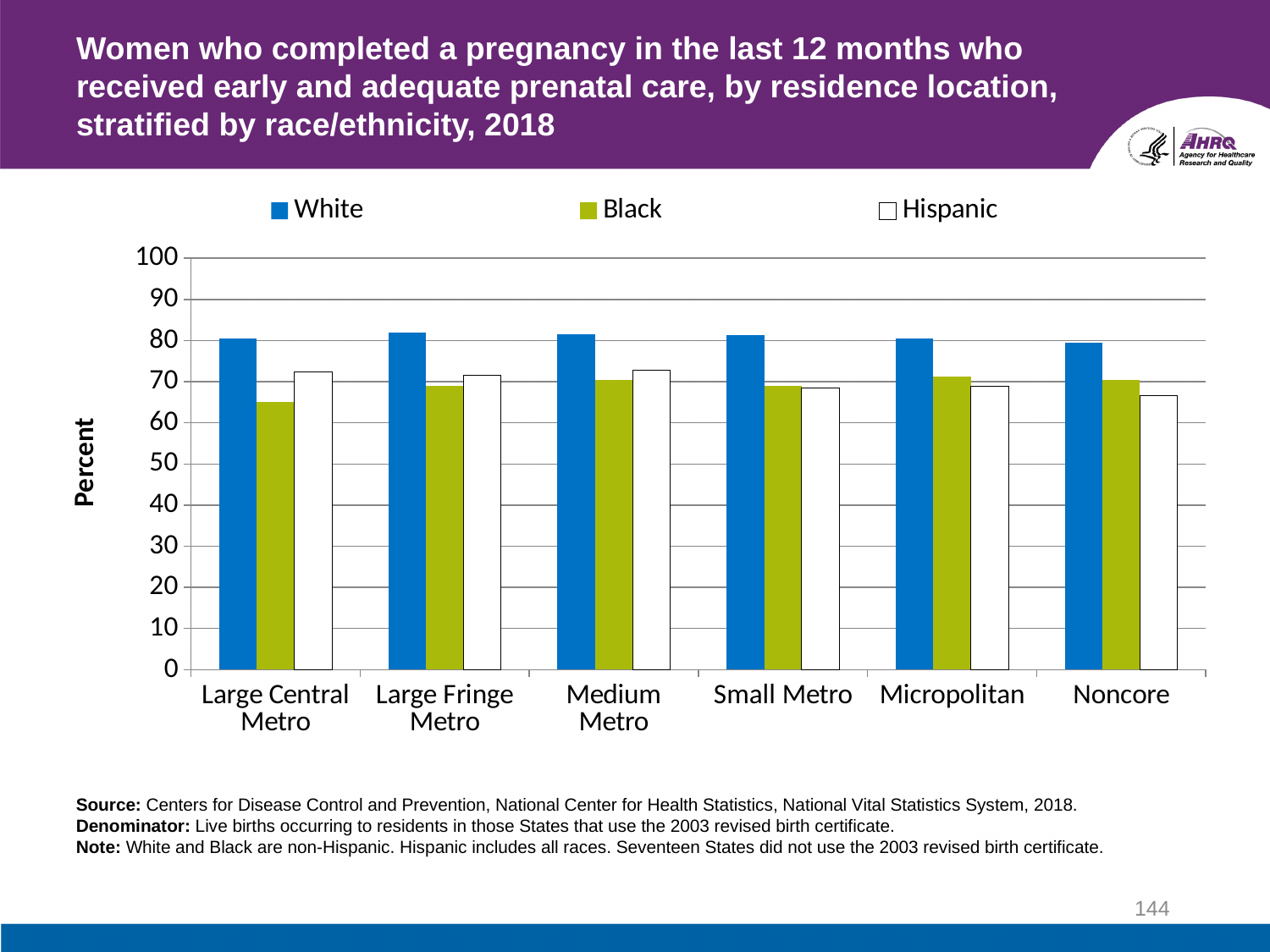
How many series does the legend list? 3 How many residence location categories are shown on the x axis? 6 Is the value for Black in Large Central Metro greater or less than 70? less Is the value for Hispanic in Noncore greater or less than 70? less In Large Central Metro, which is larger, the value for White or the value for Black? White What kind of chart is shown on the slide? bar chart Is the value for Hispanic in Medium Metro greater or less than 70? greater Among the residence locations, which has the lowest value for Black? Large Central Metro Which series has the highest value in Small Metro? White What is the label on the vertical axis? Percent In Large Central Metro, which is larger, the value for Hispanic or the value for Black? Hispanic